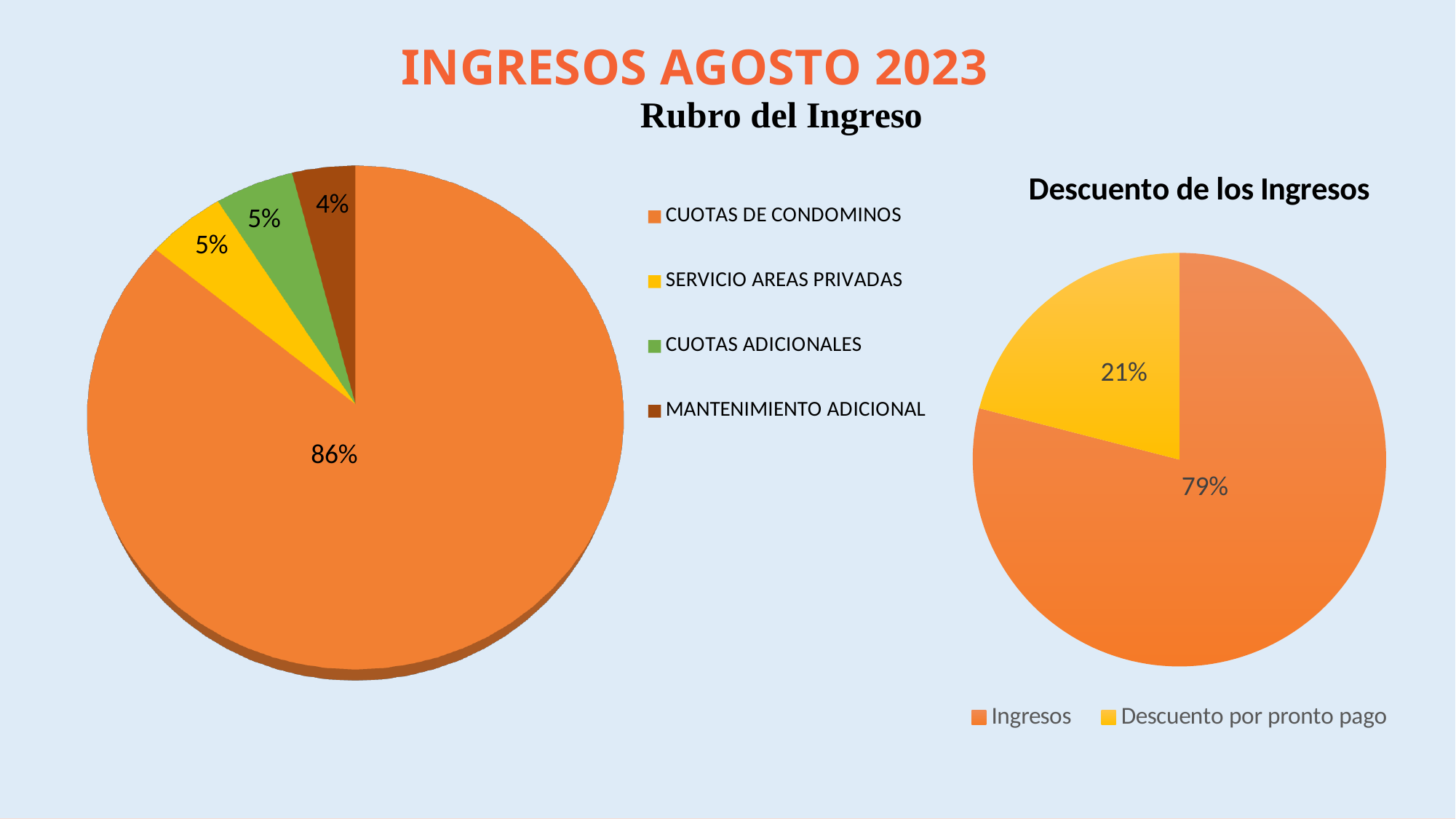
In the 'Descuento de los Ingresos' chart, what share does Ingresos have? 79% In the 'Rubro del Ingreso' chart, which category has the largest slice? CUOTAS DE CONDOMINOS In the 'Rubro del Ingreso' chart, what share does MANTENIMIENTO ADICIONAL have? 4% In the 'Rubro del Ingreso' chart, what share does CUOTAS DE CONDOMINOS have? 86% In the 'Descuento de los Ingresos' chart, which is larger, Ingresos or Descuento por pronto pago? Ingresos In the 'Rubro del Ingreso' chart, what is the difference in percentage points between CUOTAS DE CONDOMINOS and CUOTAS ADICIONALES? 81 In the 'Rubro del Ingreso' chart, how many categories are shown? 4 What kind of chart is 'Descuento de los Ingresos'? Pie chart In the 'Rubro del Ingreso' chart, which category has the smallest slice? MANTENIMIENTO ADICIONAL In the 'Descuento de los Ingresos' chart, how many entries does the legend list? 2